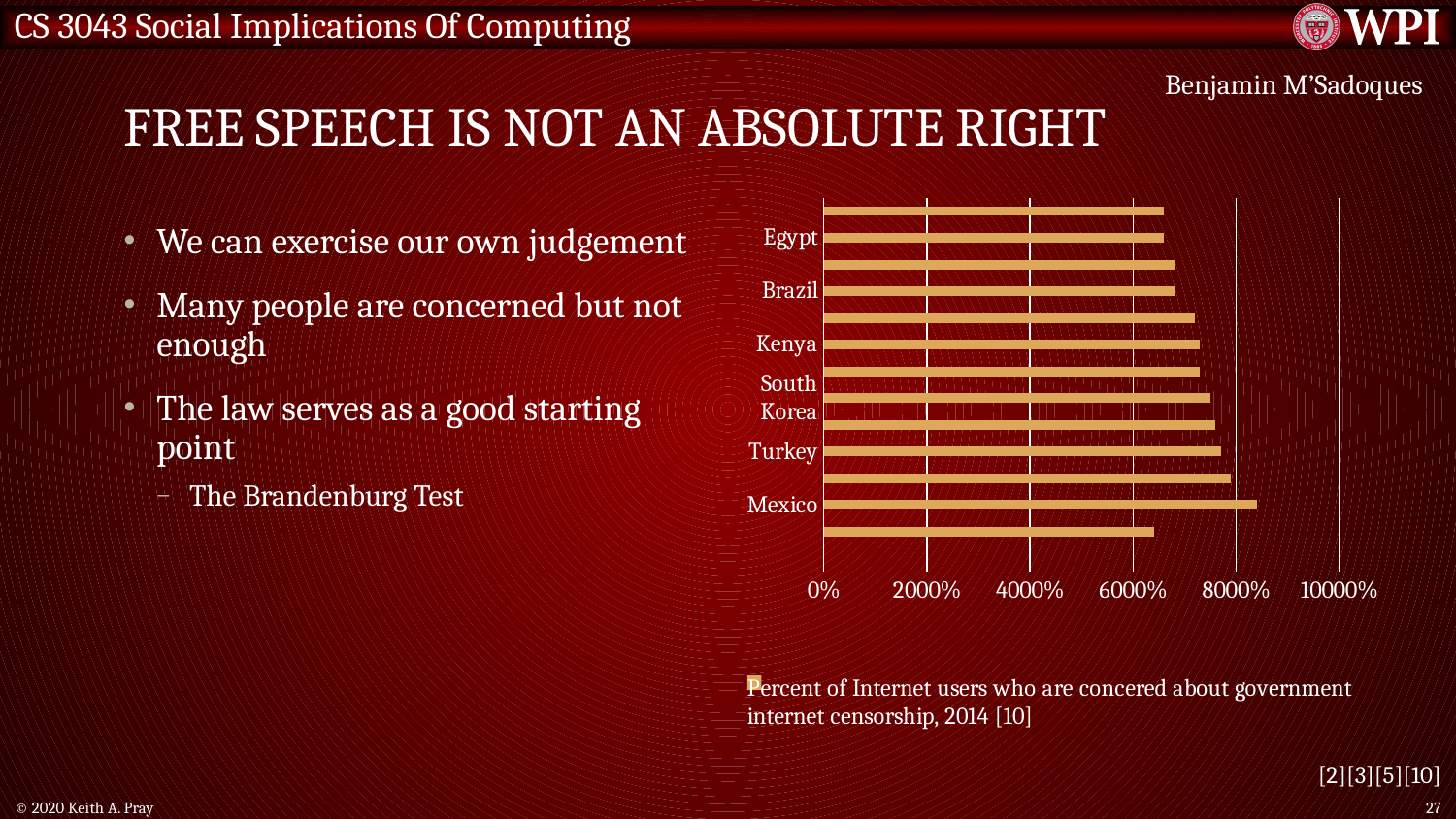
According to the caption, what does the chart show? Percent of Internet users who are concered about government internet censorship, 2014 Which is larger, the value for Turkey or the value for Brazil? Turkey Which is larger, the value for Mexico or the value for Egypt? Mexico What kind of chart is shown on the slide? bar chart How many bars are plotted in the chart? 13 Is the value for Mexico greater or less than 6000%? greater Which of the labeled countries has the longest bar? Mexico Is the value for Turkey greater or less than 4000%? greater What is the highest value shown on the horizontal axis? 10000% Which of the labeled countries has the shortest bar? Egypt Is the value for Egypt greater or less than 8000%? less